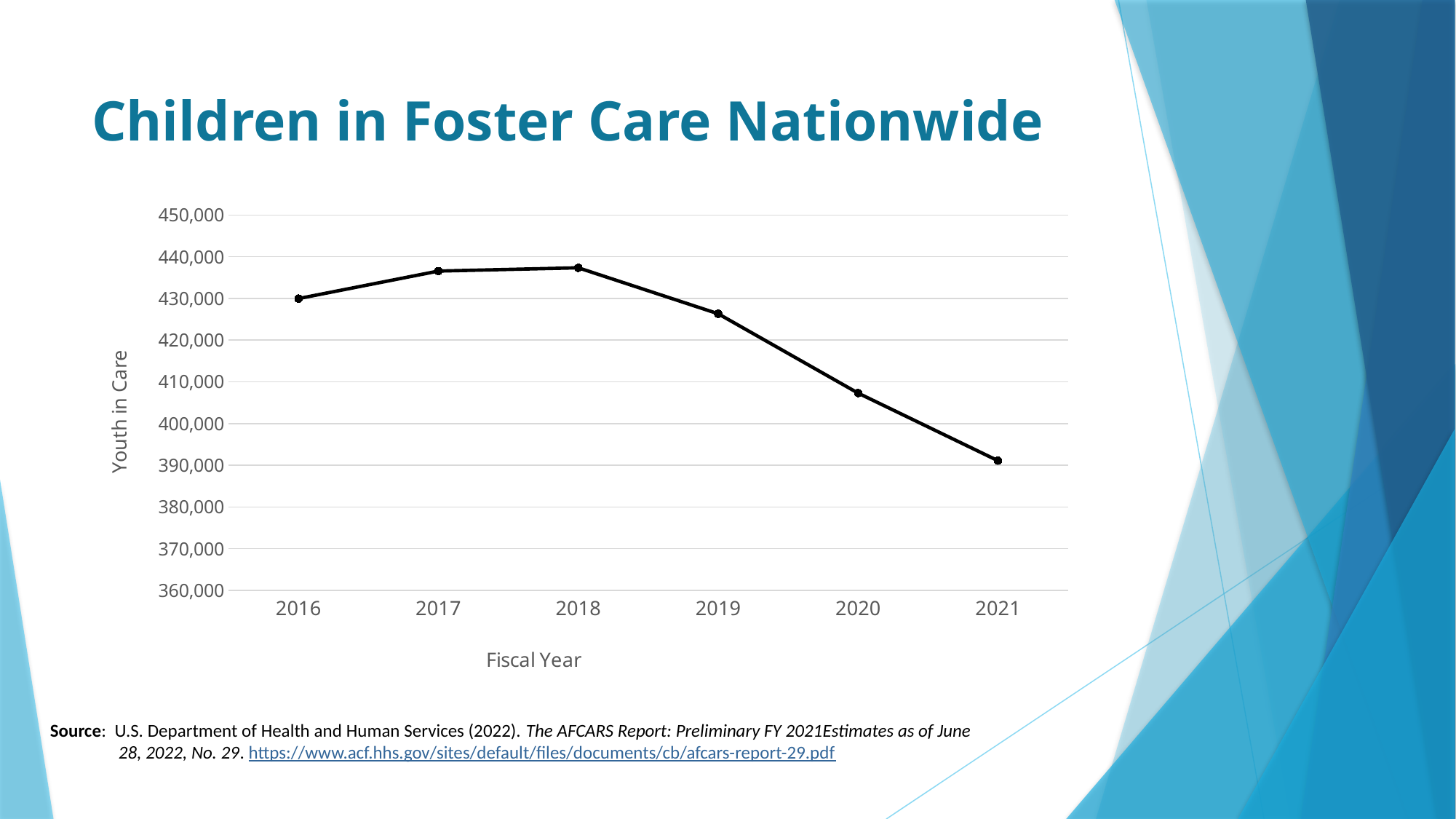
Which fiscal year has the lowest number of youth in care? 2021 Is the value for 2019 greater or less than 420,000? greater Is the value for 2017 greater or less than 430,000? greater Is the value for 2020 greater or less than 400,000? greater What is the label on the vertical axis of the chart? Youth in Care What kind of chart is shown on the slide? line chart Which year has the larger value, 2016 or 2021? 2016 Do the values rise or fall from 2018 to 2021? fall Which year has the larger value, 2019 or 2020? 2019 How many fiscal years are plotted on the chart? 6